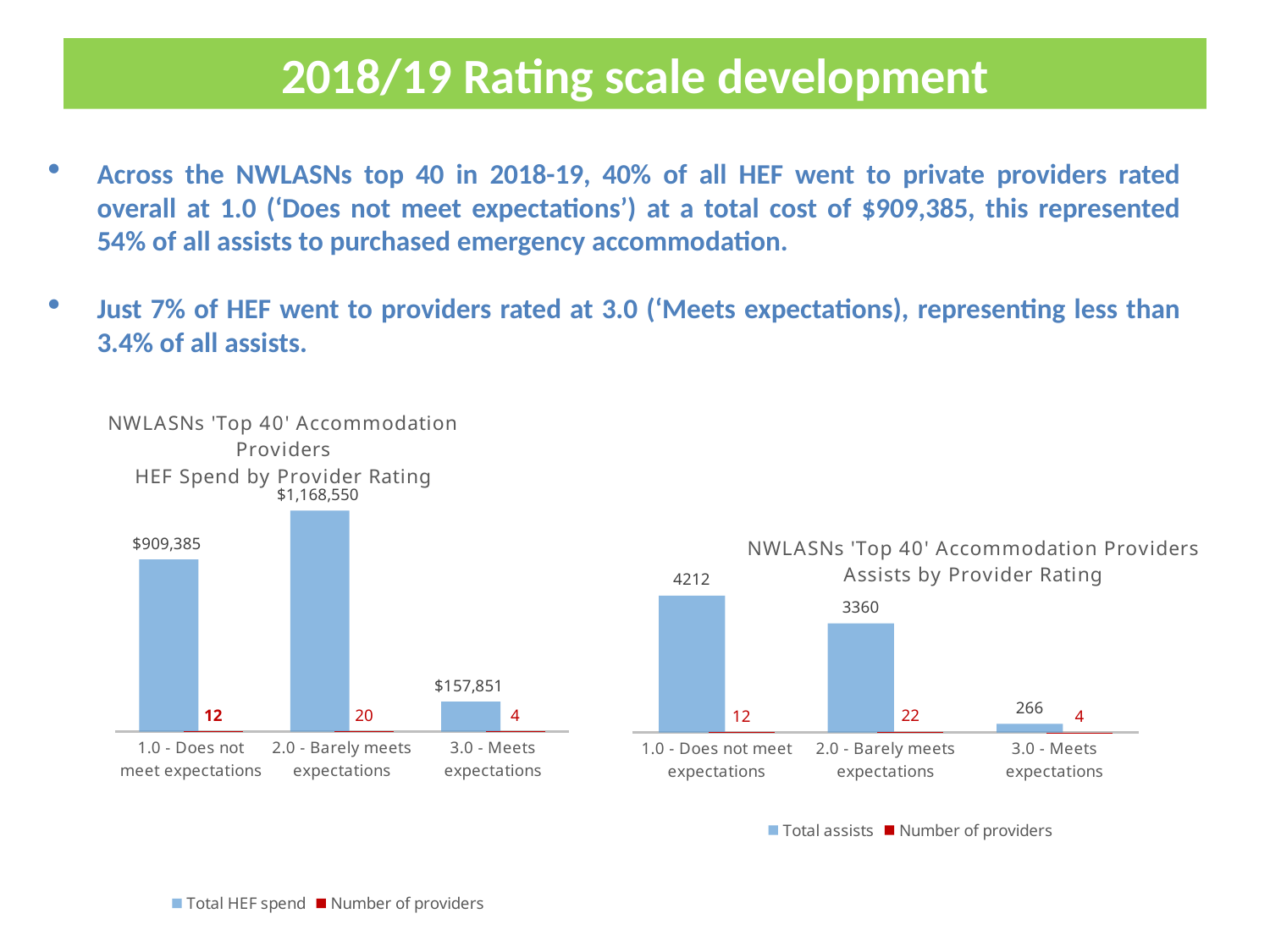
In the HEF Spend by Provider Rating chart, what is the Total HEF spend for providers rated 2.0 - Barely meets expectations? $1,168,550 In the HEF Spend by Provider Rating chart, how many providers are rated 2.0 - Barely meets expectations? 20 How many series does the legend of the Assists by Provider Rating chart list? 2 In the Assists by Provider Rating chart, what is the difference in Total assists between the 1.0 and 2.0 rating categories? 852 In the HEF Spend by Provider Rating chart, what is the difference in Total HEF spend between the 2.0 and 1.0 rating categories? $259,165 In the Assists by Provider Rating chart, how many providers are rated 2.0 - Barely meets expectations? 22 In the Assists by Provider Rating chart, do Total assists rise or fall as the provider rating increases from 1.0 to 3.0? fall What type of chart is the HEF Spend by Provider Rating chart? bar chart In the HEF Spend by Provider Rating chart, what is the Total HEF spend for providers rated 3.0 - Meets expectations? $157,851 In the HEF Spend by Provider Rating chart, which rating category has the highest Total HEF spend? 2.0 - Barely meets expectations In the Assists by Provider Rating chart, what is the number of Total assists for providers rated 1.0 - Does not meet expectations? 4212 In the Assists by Provider Rating chart, which rating category has the lowest number of Total assists? 3.0 - Meets expectations